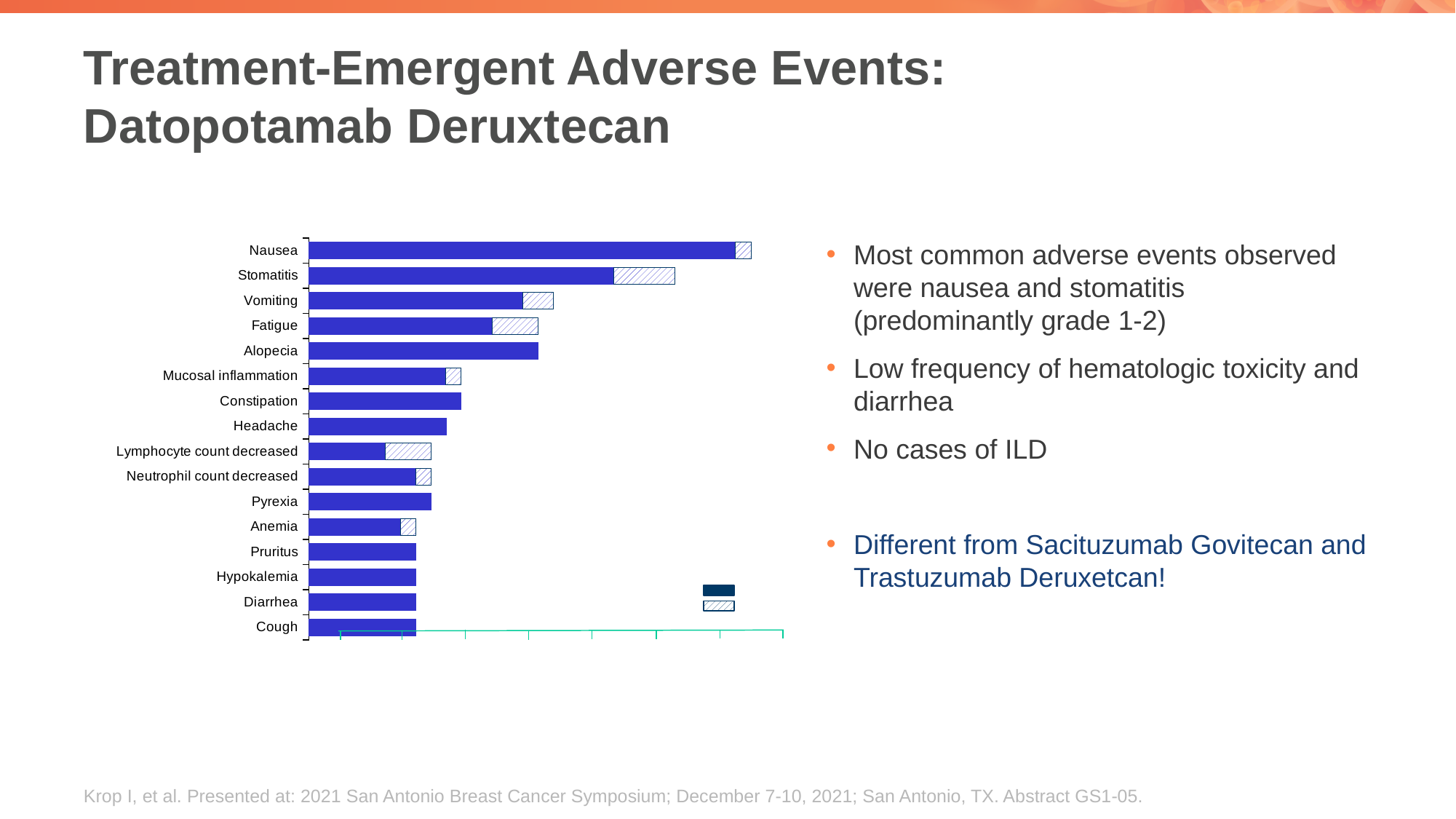
Do the bar lengths generally increase or decrease going from the top category to the bottom category? decrease Which adverse event is listed at the top of the chart? Nausea Which adverse event has the longest bar on the chart? Nausea How many series (bar patterns) does the legend show? 2 Which has the longer total bar, Nausea or Stomatitis? Nausea Which has the longer bar, Headache or Pyrexia? Headache How many adverse event categories are plotted on the chart? 16 Which has the longer total bar, Lymphocyte count decreased or Anemia? Lymphocyte count decreased What kind of chart is shown on the slide? bar chart Which adverse event is listed at the bottom of the chart? Cough